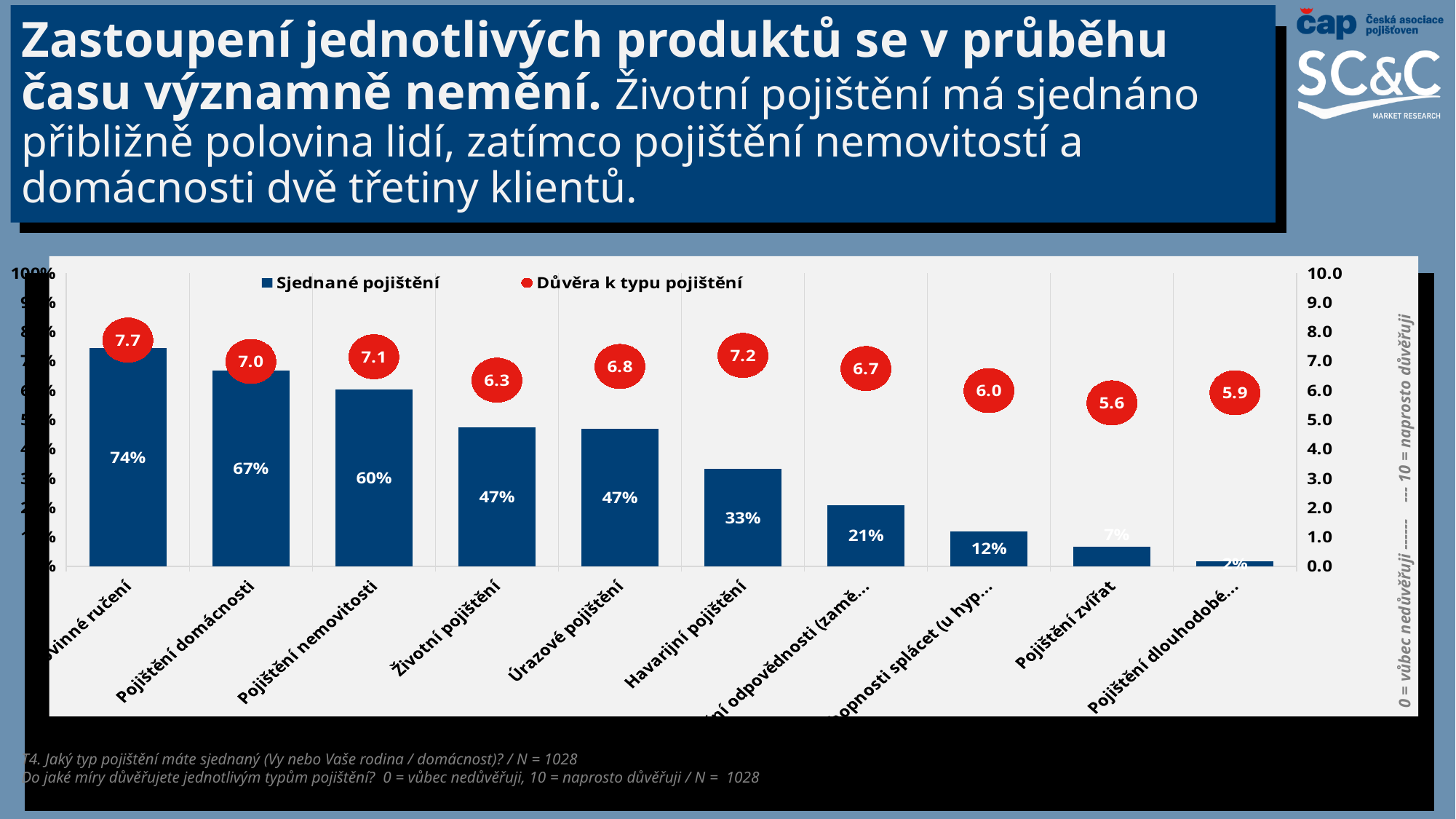
What kind of chart is used for the Sjednané pojištění series? bar chart What is the Sjednané pojištění value for Havarijní pojištění? 33% What is the Sjednané pojištění value for Pojištění domácnosti? 67% Which category has the lowest Důvěra k typu pojištění score? Pojištění zvířat What is the Důvěra k typu pojištění score for Pojištění zvířat? 5.6 How many series does the chart legend list? 2 Do the Sjednané pojištění bar values rise or fall from left to right along the x axis? fall How many categories are shown on the x axis of the chart? 10 Which has a higher Důvěra k typu pojištění score, Pojištění nemovitosti or Pojištění domácnosti? Pojištění nemovitosti What is the Důvěra k typu pojištění score for Životní pojištění? 6.3 Which has a higher Sjednané pojištění value, Úrazové pojištění or Havarijní pojištění? Úrazové pojištění What is the difference in Sjednané pojištění between Pojištění nemovitosti and Životní pojištění? 13%